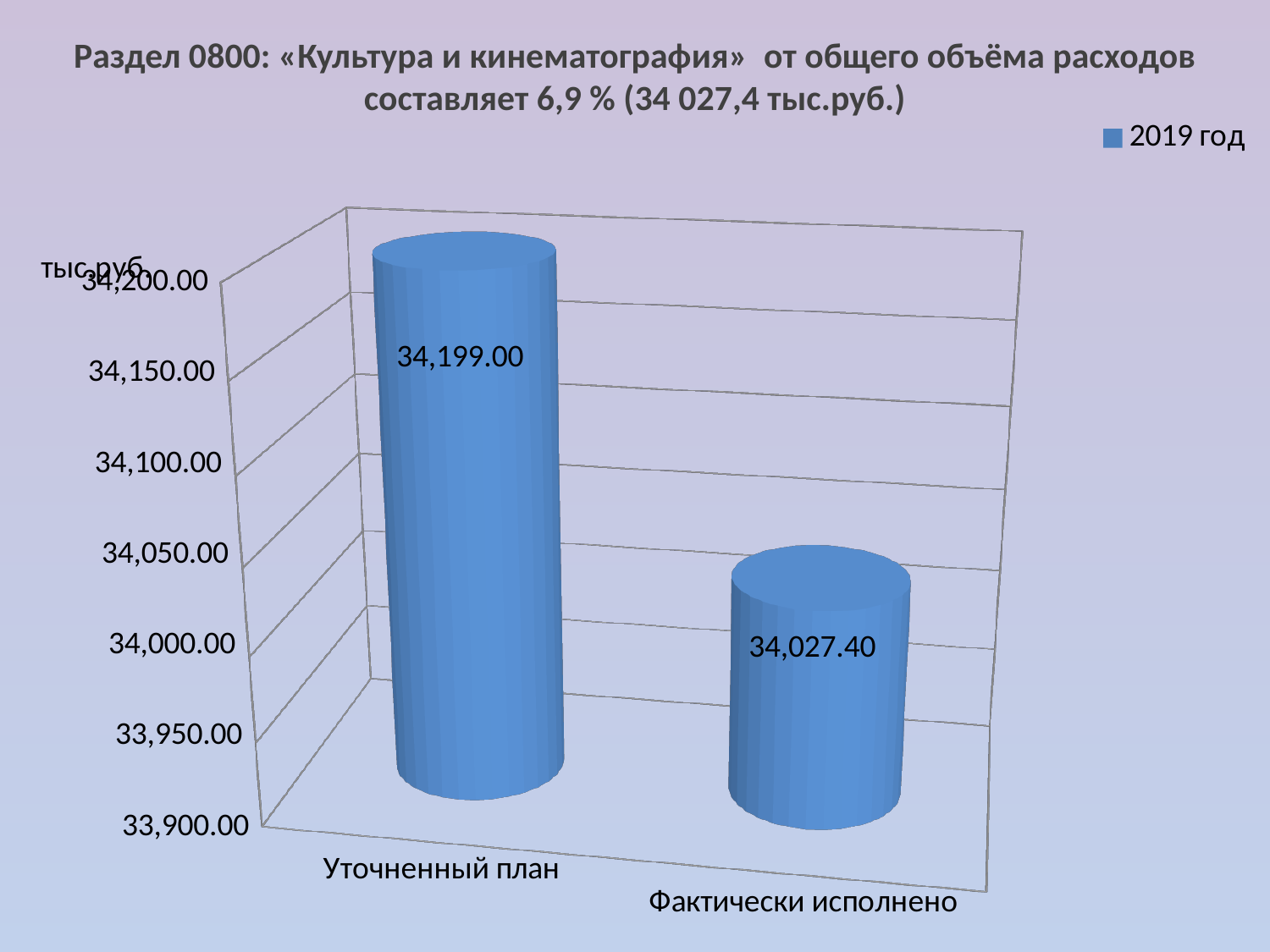
Is the value for Уточненный план greater or less than 34,150.00? greater Which is larger, the value for Уточненный план or the value for Фактически исполнено? Уточненный план What is the value for Уточненный план? 34,199.00 What series name is shown in the legend? 2019 год Which category has the highest value? Уточненный план Which category has the lowest value? Фактически исполнено How many series does the legend list? 1 What kind of chart is shown on the slide? bar chart What is the value for Фактически исполнено? 34,027.40 Is the value for Фактически исполнено greater or less than 34,050.00? less How many categories are shown on the x axis? 2 What is the difference between the values for Уточненный план and Фактически исполнено? 171.60